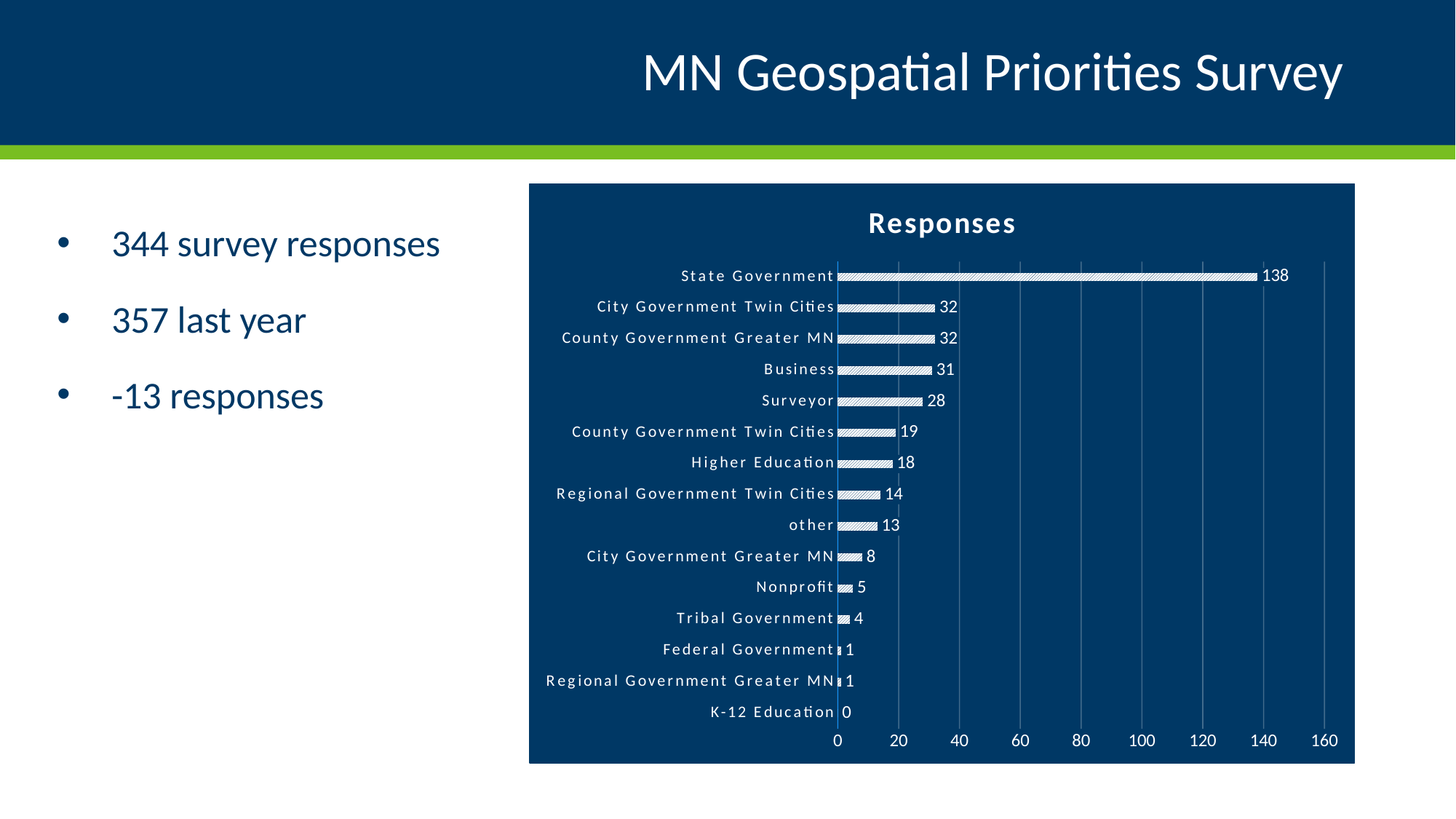
Which category has the highest value? State Government What is the difference between State Government and Business? 107 What is the title of the chart? Responses Which category has the lowest value? K-12 Education What is the value for Surveyor? 28 What is the value for Higher Education? 18 Which is larger, County Government Twin Cities or Regional Government Twin Cities? County Government Twin Cities What kind of chart is shown? bar chart Is the value for State Government greater or less than 120? greater How many categories are shown in the chart? 15 What is the value for State Government? 138 What is the value for Nonprofit? 5